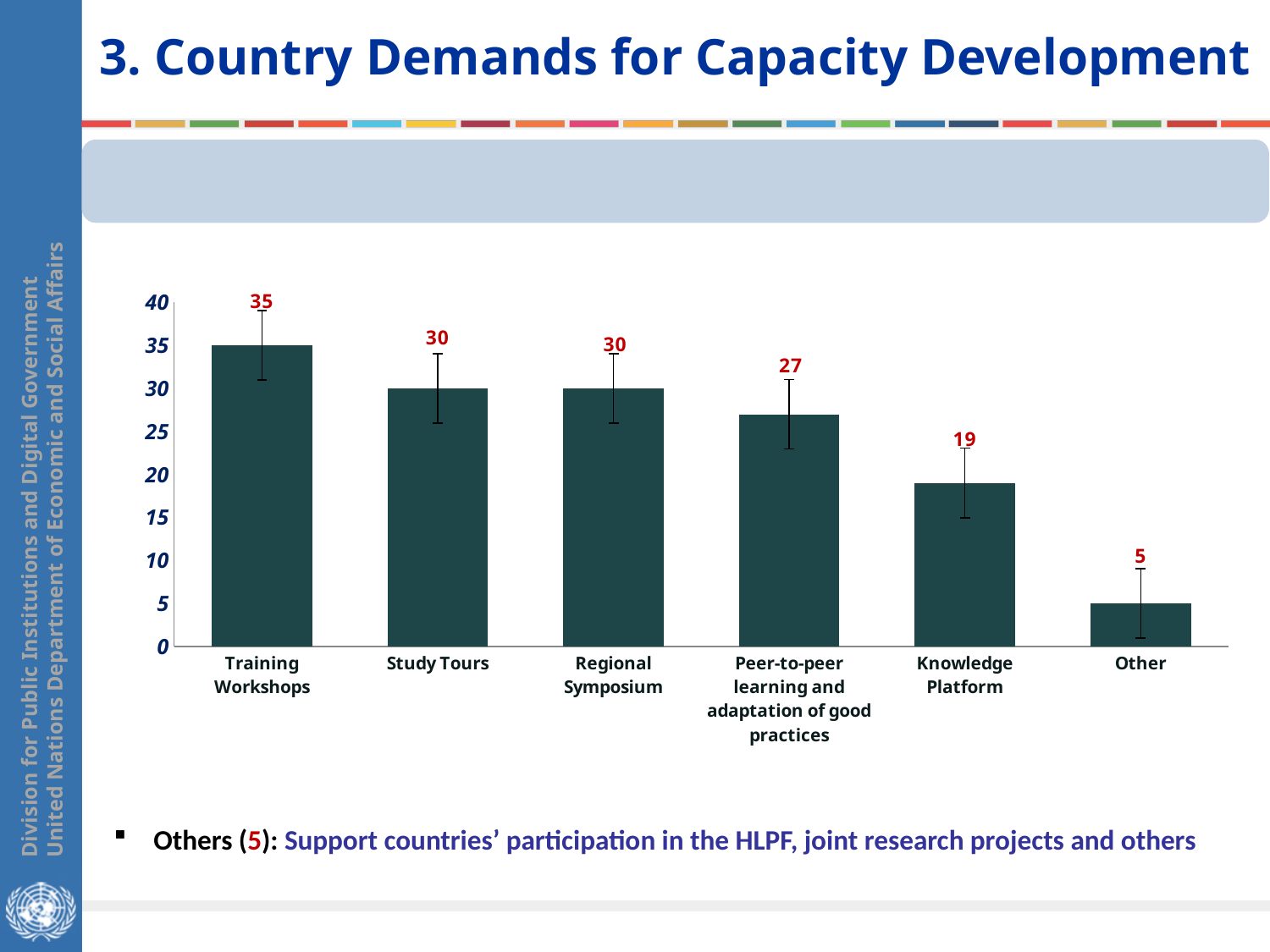
How many categories are shown on the x axis? 6 What is the value for Training Workshops? 35 Which category has the lowest value? Other Which is larger, the value for Study Tours or the value for Peer-to-peer learning and adaptation of good practices? Study Tours What is the difference between the values for Training Workshops and Knowledge Platform? 16 What kind of chart is shown on the slide? bar chart What is the value for Knowledge Platform? 19 Is the value for Knowledge Platform greater or less than 20? less Which category has the highest value? Training Workshops Do the values rise or fall from left to right along the x axis? fall What is the value for Other? 5 What is the value for Peer-to-peer learning and adaptation of good practices? 27